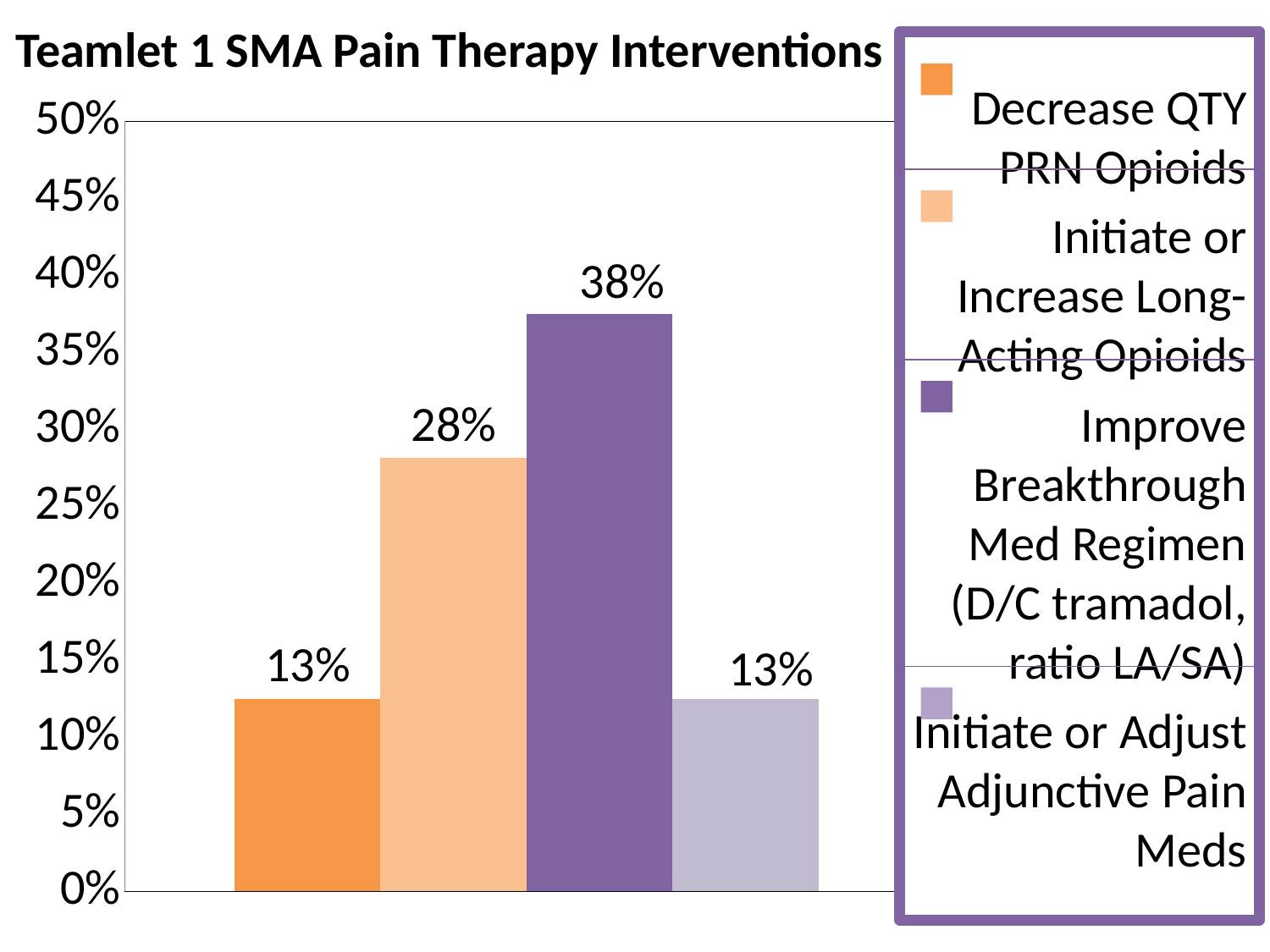
What is the difference between the values for Initiate or Increase Long-Acting Opioids and Decrease QTY PRN Opioids? 15% What is the value for Initiate or Increase Long-Acting Opioids? 28% What is the difference between the values for Improve Breakthrough Med Regimen and Initiate or Increase Long-Acting Opioids? 10% What is the value for Initiate or Adjust Adjunctive Pain Meds? 13% Which is larger, the value for Initiate or Increase Long-Acting Opioids or the value for Initiate or Adjust Adjunctive Pain Meds? Initiate or Increase Long-Acting Opioids What is the title of the chart? Teamlet 1 SMA Pain Therapy Interventions What is the value for Decrease QTY PRN Opioids? 13% Is the value for Improve Breakthrough Med Regimen greater or less than 35%? greater What kind of chart is shown on the slide? bar chart Which intervention has the highest value? Improve Breakthrough Med Regimen (D/C tramadol, ratio LA/SA) How many bars are shown in the chart? 4 What is the value for Improve Breakthrough Med Regimen (D/C tramadol, ratio LA/SA)? 38%